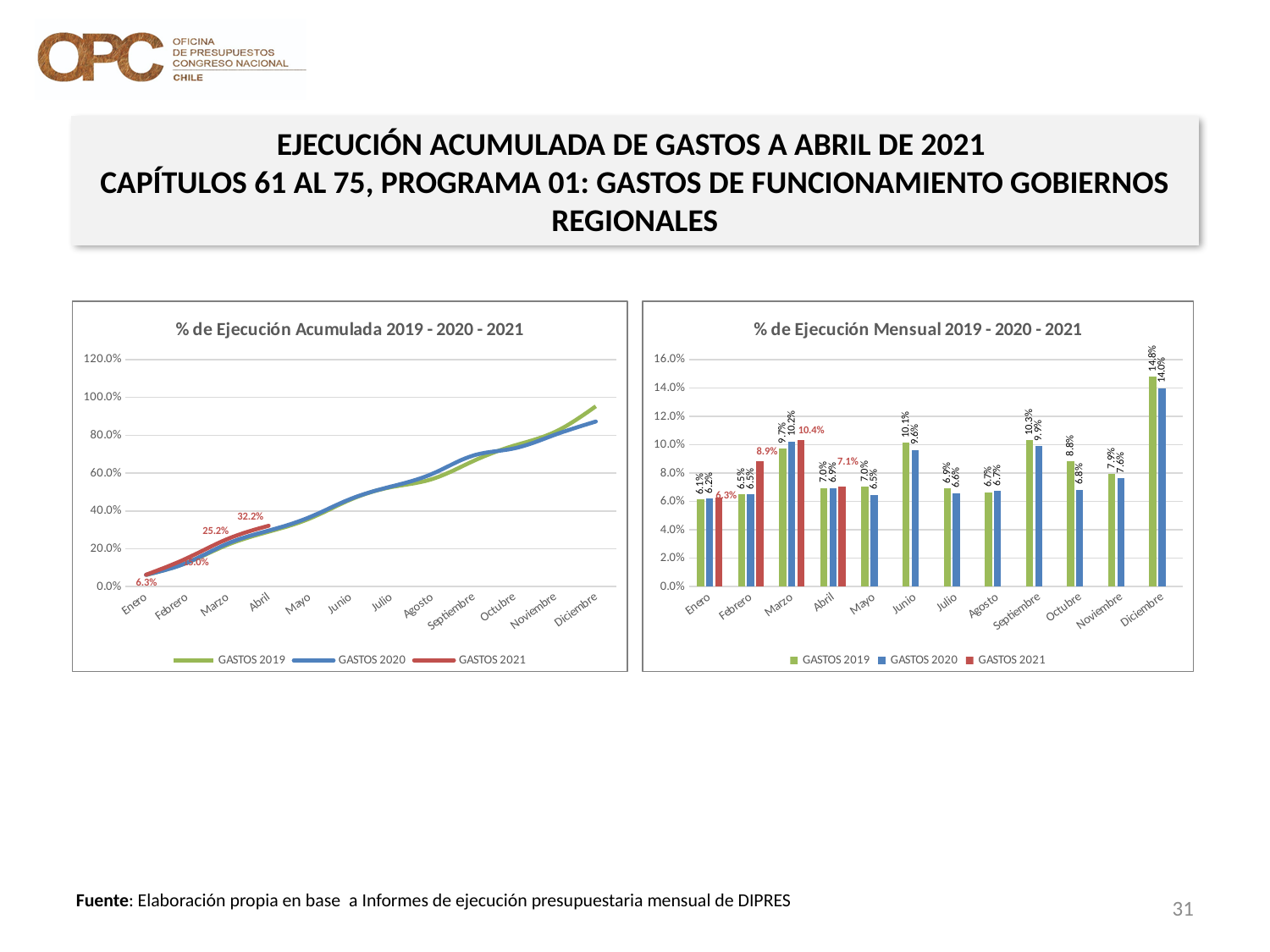
In the '% de Ejecución Mensual 2019 - 2020 - 2021' chart, what is the value for GASTOS 2021 in Febrero? 8.9% How many months are shown on the x axis of the '% de Ejecución Mensual 2019 - 2020 - 2021' chart? 12 What kind of chart is the left-hand chart, '% de Ejecución Acumulada 2019 - 2020 - 2021'? Line chart In the '% de Ejecución Mensual 2019 - 2020 - 2021' chart, how many series does the legend list? 3 In the '% de Ejecución Mensual 2019 - 2020 - 2021' chart, which month has the highest value for GASTOS 2020? Diciembre In the '% de Ejecución Acumulada 2019 - 2020 - 2021' chart, is the value for GASTOS 2019 in Diciembre greater or less than 80.0%? greater What kind of chart is the right-hand chart, '% de Ejecución Mensual 2019 - 2020 - 2021'? Bar chart In the '% de Ejecución Acumulada 2019 - 2020 - 2021' chart, what is the value for GASTOS 2021 in Abril? 32.2% In the '% de Ejecución Mensual 2019 - 2020 - 2021' chart, what is the difference between GASTOS 2019 and GASTOS 2020 in Diciembre? 0.8% In the '% de Ejecución Mensual 2019 - 2020 - 2021' chart, what is the value for GASTOS 2019 in Diciembre? 14.8% In the '% de Ejecución Acumulada 2019 - 2020 - 2021' chart, what is the value for GASTOS 2021 in Marzo? 25.2% In the '% de Ejecución Mensual 2019 - 2020 - 2021' chart, which is larger in Octubre, GASTOS 2019 or GASTOS 2020? GASTOS 2019